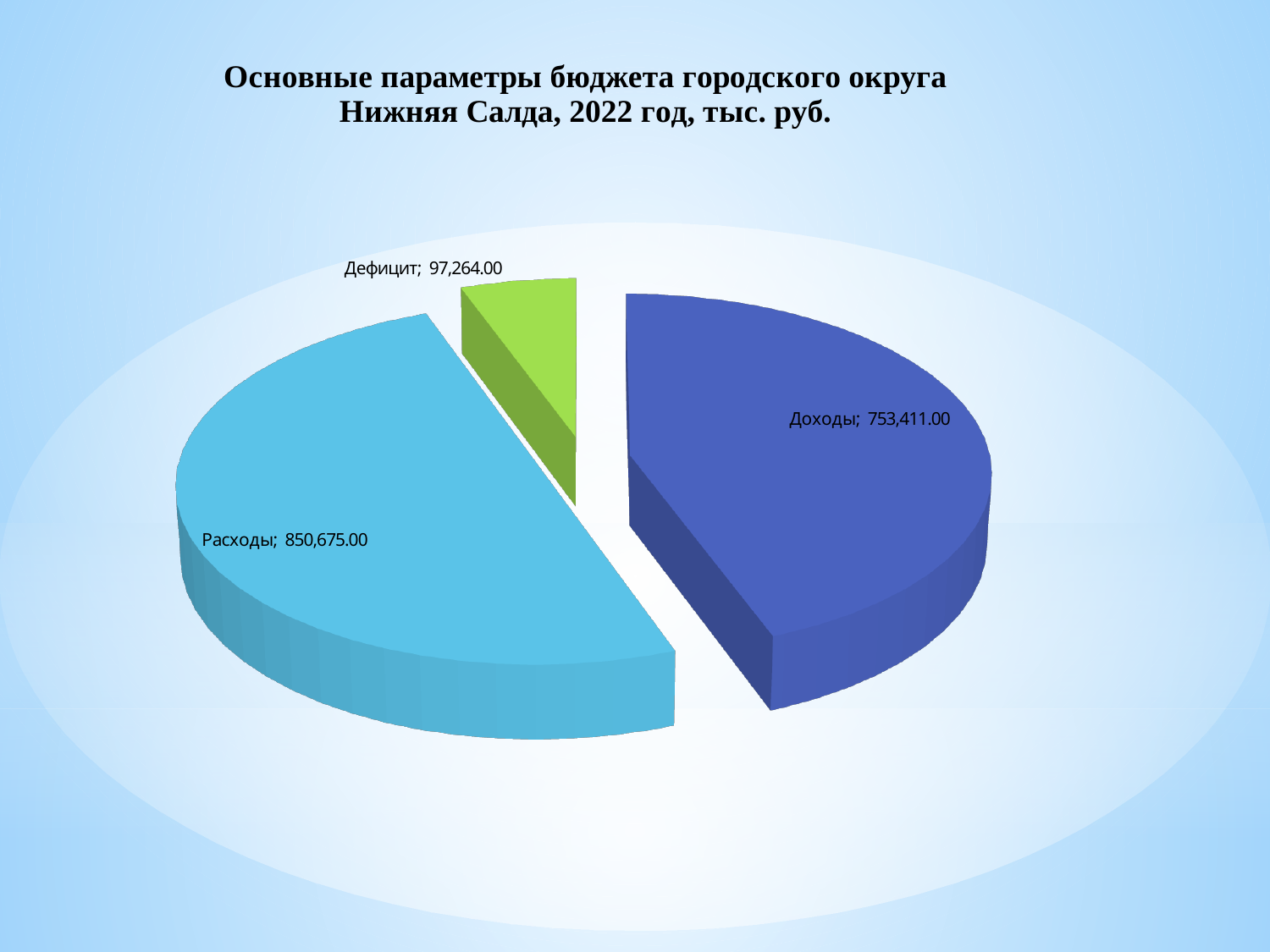
Which is larger, Доходы or Расходы? Расходы How many slices does the pie chart have? 3 What is the difference between Расходы and Доходы? 97,264.00 What is the value shown for Расходы? 850,675.00 Which category has the smallest slice of the pie? Дефицит What is the difference between Доходы and Дефицит? 656,147.00 What colour is the Дефицит slice? Green What is the value shown for Доходы? 753,411.00 What is the value shown for Дефицит? 97,264.00 What is the title of the chart? Основные параметры бюджета городского округа Нижняя Салда, 2022 год, тыс. руб. What kind of chart is shown on the slide? Pie chart Which category has the largest slice of the pie? Расходы